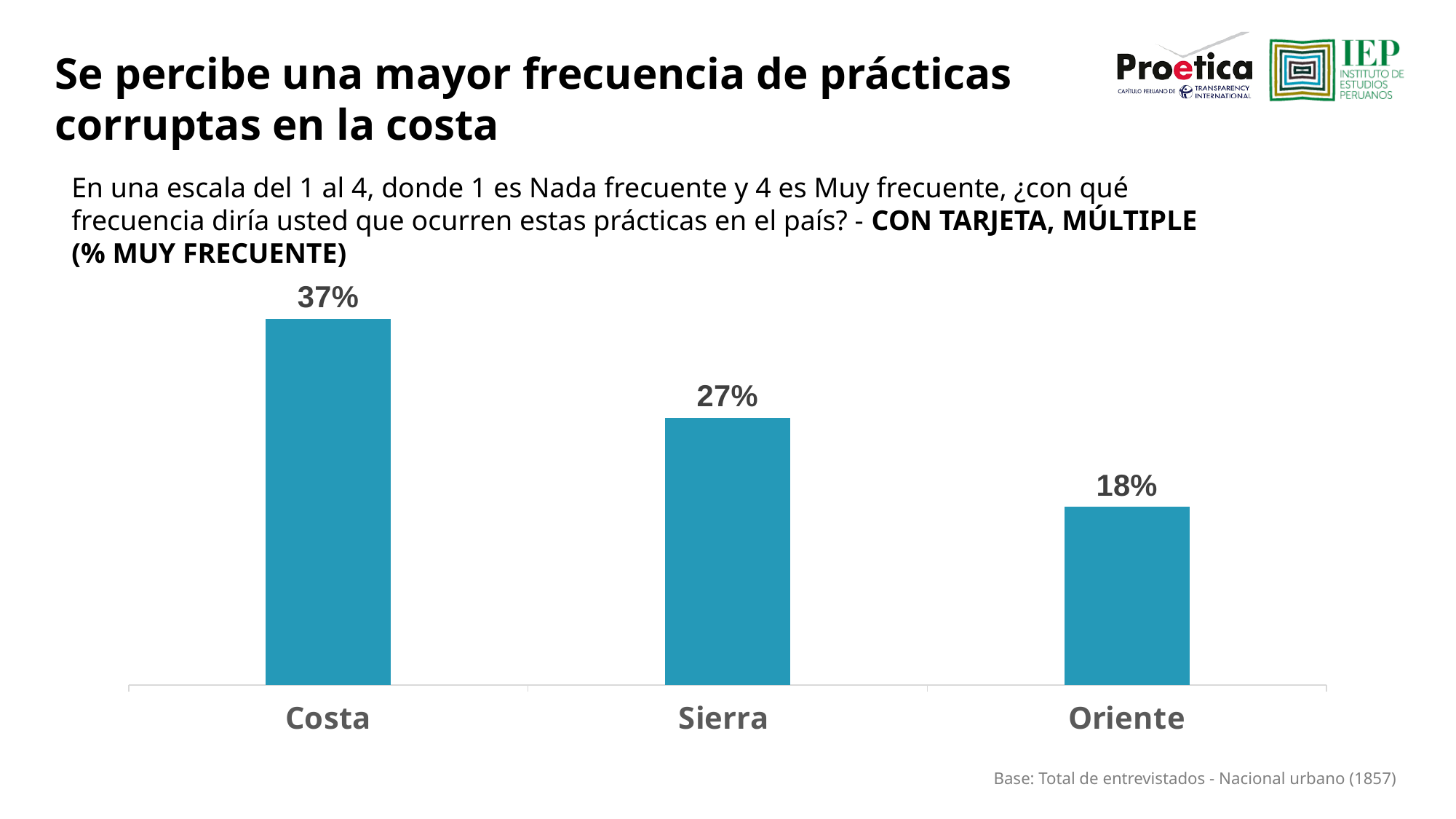
What is the difference between the values for Sierra and Oriente? 9% Which region has the lowest value? Oriente What is the value for Sierra? 27% What is the difference between the values for Costa and Sierra? 10% What kind of chart is shown on the slide? Bar chart Do the values rise or fall from Costa to Oriente along the x axis? Fall What is the value for Costa? 37% How many regions are shown in the chart? 3 Which region has the highest value? Costa Which is larger, the value for Sierra or the value for Oriente? Sierra What is the difference between the values for Costa and Oriente? 19% What is the value for Oriente? 18%